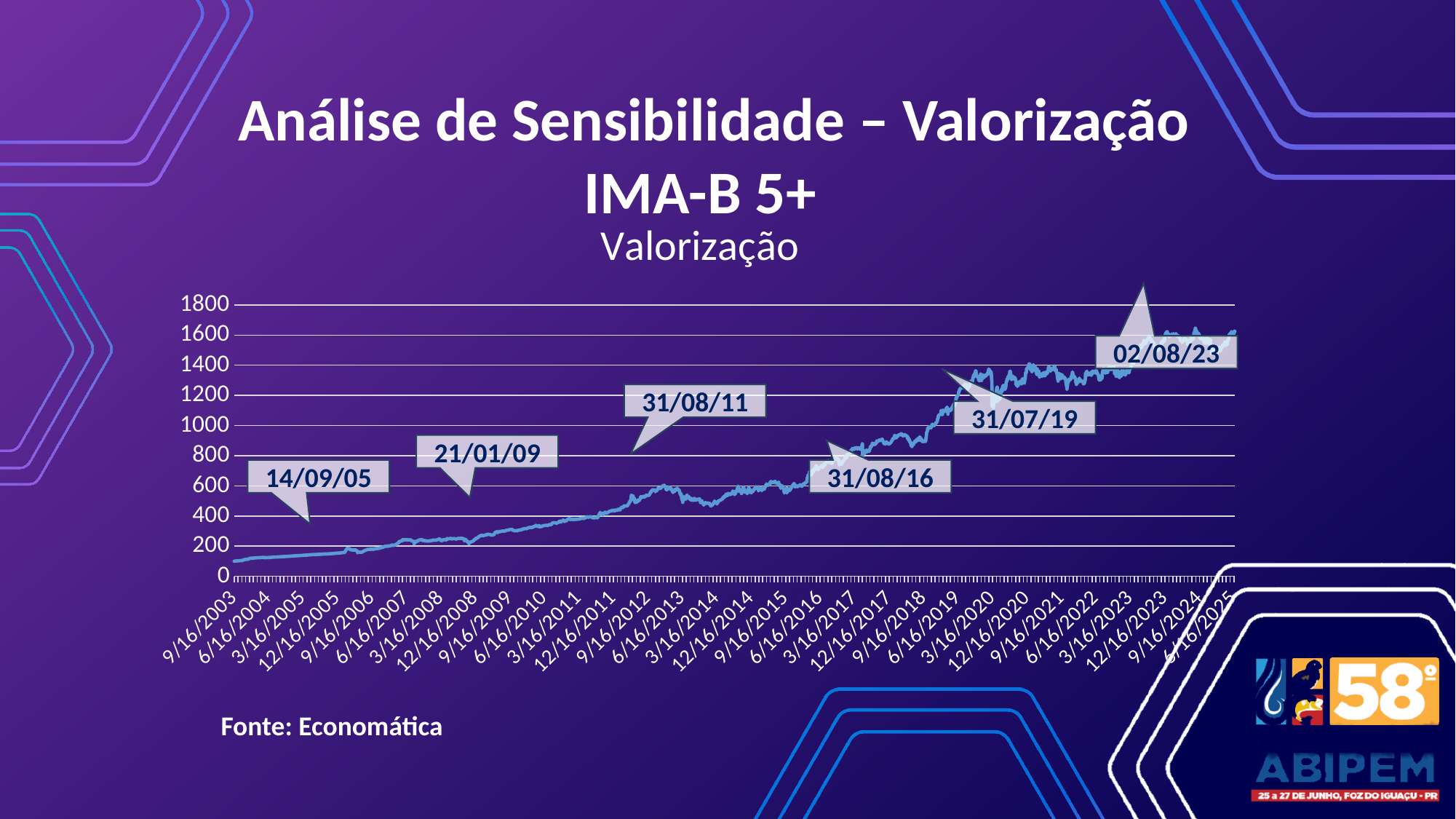
What is the highest value shown on the vertical axis? 1800 What source is cited for the chart? Economática Which date is marked by the last callout label on the chart? 02/08/23 Is the value at the start of the series (9/16/2003) greater or less than 200? less Is the value at the end of the series (6/16/2025) greater or less than 1400? greater Is the value around 6/16/2013 greater or less than 400? greater Do the values in the chart generally rise or fall from 2003 to 2025? rise Which date is marked by the first callout label on the chart? 14/09/05 What kind of chart is shown on the slide? line chart What is the title of the chart? Valorização